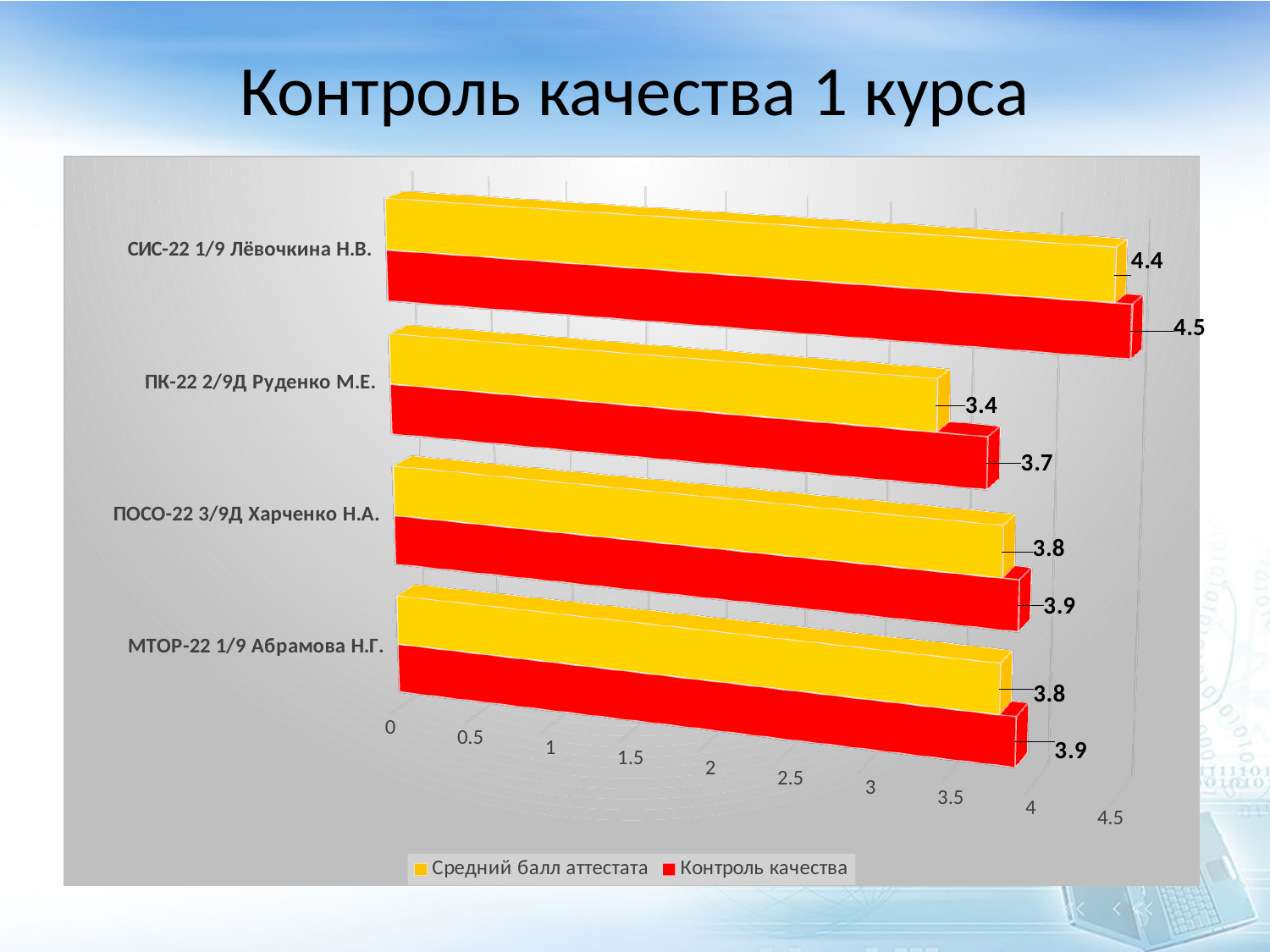
What is the value of Контроль качества for МТОР-22 1/9 Абрамова Н.Г.? 3.9 What is the value of Средний балл аттестата for ПОСО-22 3/9Д Харченко Н.А.? 3.8 How many categories are shown in the chart? 4 What is the value of Контроль качества for СИС-22 1/9 Лёвочкина Н.В.? 4.5 What kind of chart is shown on the slide? Bar chart What is the difference between Контроль качества and Средний балл аттестата for ПК-22 2/9Д Руденко М.Е.? 0.3 What is the value of Средний балл аттестата for ПК-22 2/9Д Руденко М.Е.? 3.4 Which is larger for СИС-22 1/9 Лёвочкина Н.В.: Средний балл аттестата or Контроль качества? Контроль качества Which colour represents Средний балл аттестата in the chart? Yellow How many series does the legend list? 2 Which category has the lowest value for Средний балл аттестата? ПК-22 2/9Д Руденко М.Е. Which category has the highest value for Контроль качества? СИС-22 1/9 Лёвочкина Н.В.